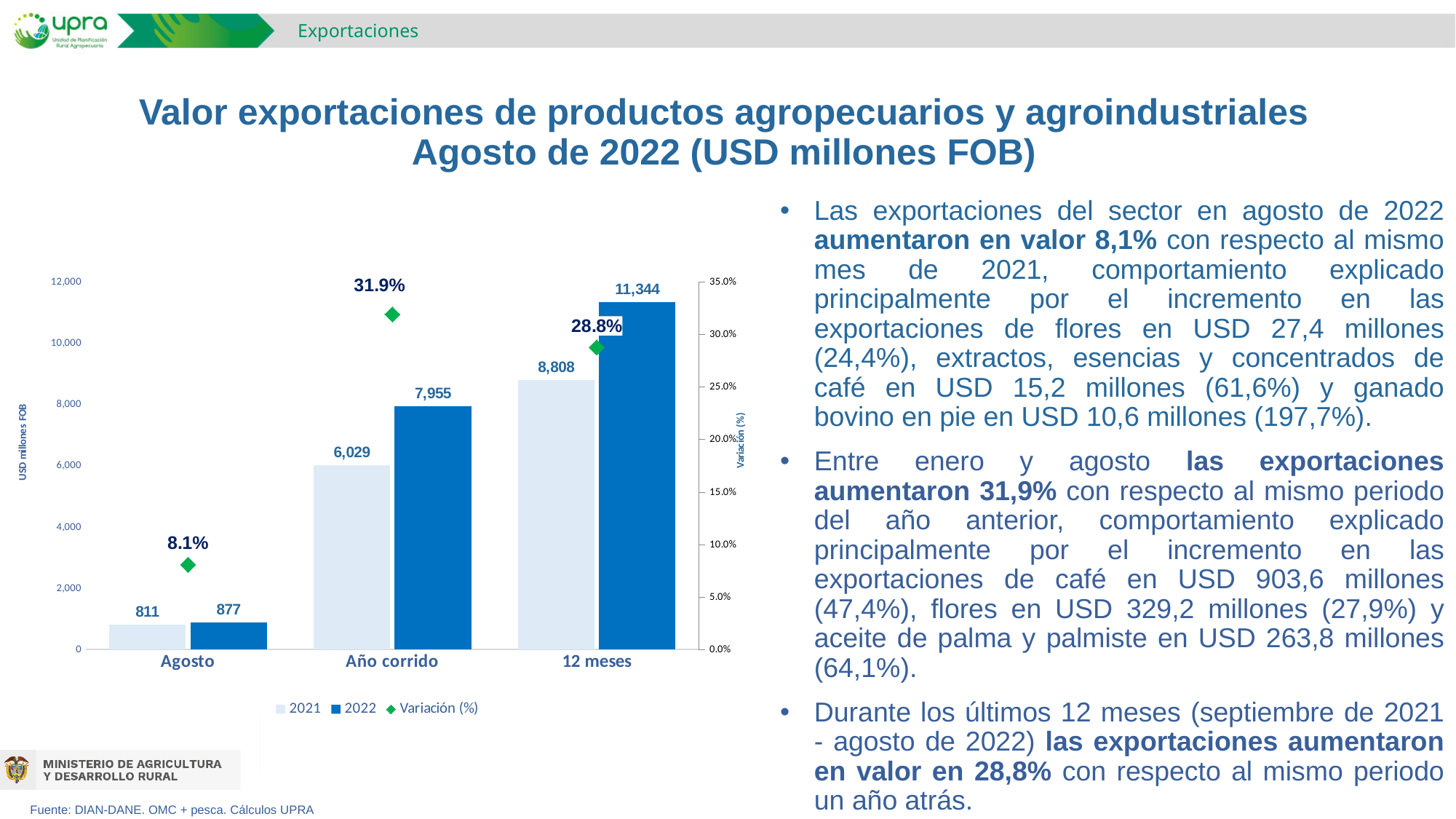
What is the Variación (%) value for 12 meses? 28.8% Which category has the lowest Variación (%)? Agosto What is the label of the left vertical axis? USD millones FOB Do the 2022 values rise or fall from Agosto to 12 meses? Rise What is the 2021 value for Año corrido? 6,029 Which is larger, the 2022 value for Año corrido or the 2021 value for 12 meses? 2021 value for 12 meses What is the difference between the 2022 and 2021 values for 12 meses? 2,536 How many series does the legend list? 3 What is the 2022 value for Agosto? 877 How many categories are shown on the x axis? 3 What kind of chart is used for the 2021 and 2022 series? Bar chart Which category has the highest 2022 value? 12 meses